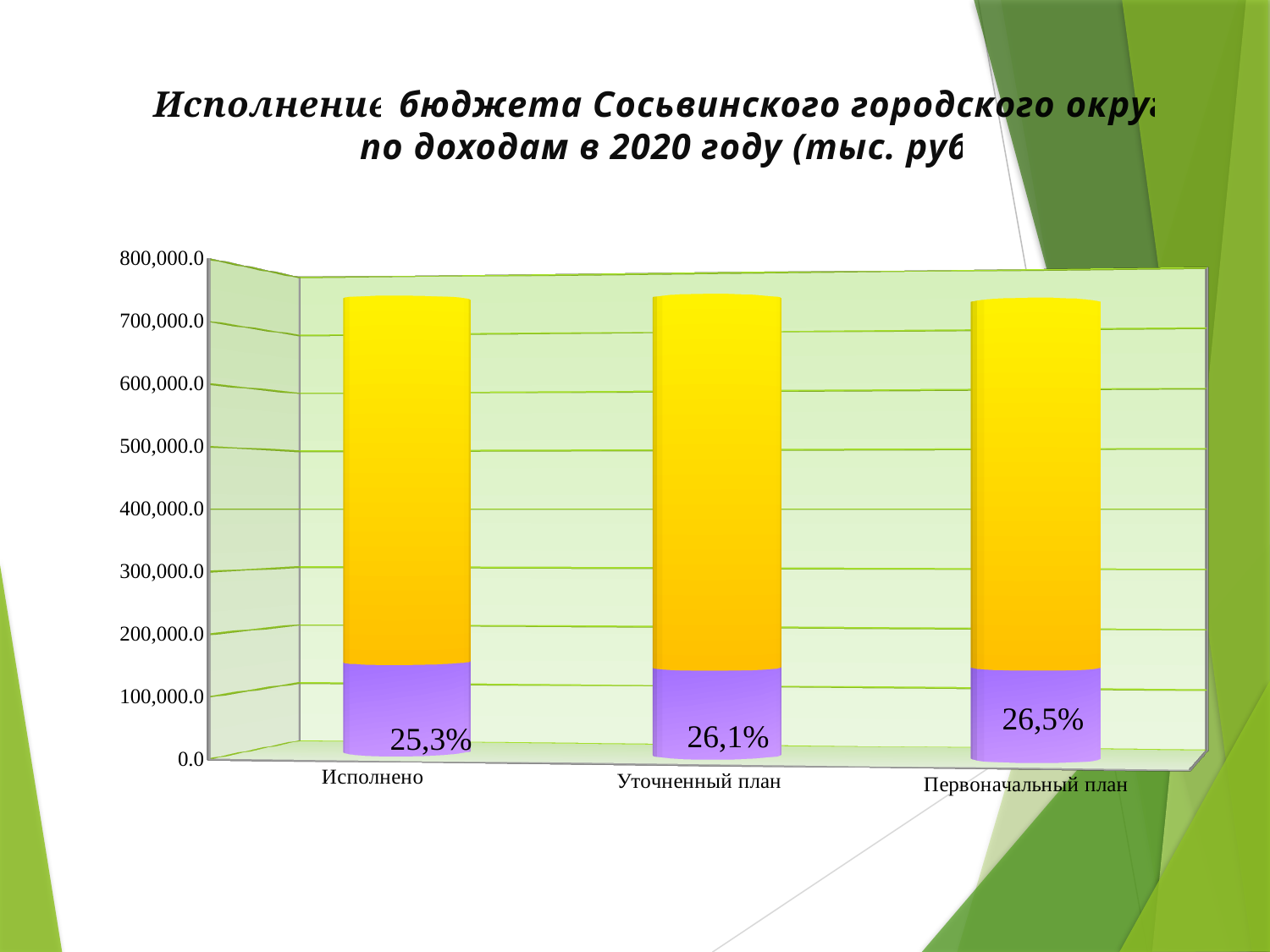
Is the total height of the Исполнено bar greater or less than 700,000.0? greater Which category has the highest percentage label on its purple segment? Первоначальный план What percentage label is shown on the purple segment of the Исполнено bar? 25,3% Which year does the chart title say the budget revenue execution refers to? 2020 What percentage label is shown on the purple segment of the Первоначальный план bar? 26,5% Is the purple segment of the Уточненный план bar greater or less than 200,000.0? less What is the difference between the percentage labels for Первоначальный план and Исполнено? 1,2% What kind of chart is shown on the slide? Stacked bar chart Which has the larger percentage label, Уточненный план or Исполнено? Уточненный план Which category has the lowest percentage label on its purple segment? Исполнено What percentage label is shown on the purple segment of the Уточненный план bar? 26,1% How many categories are shown on the x axis? 3